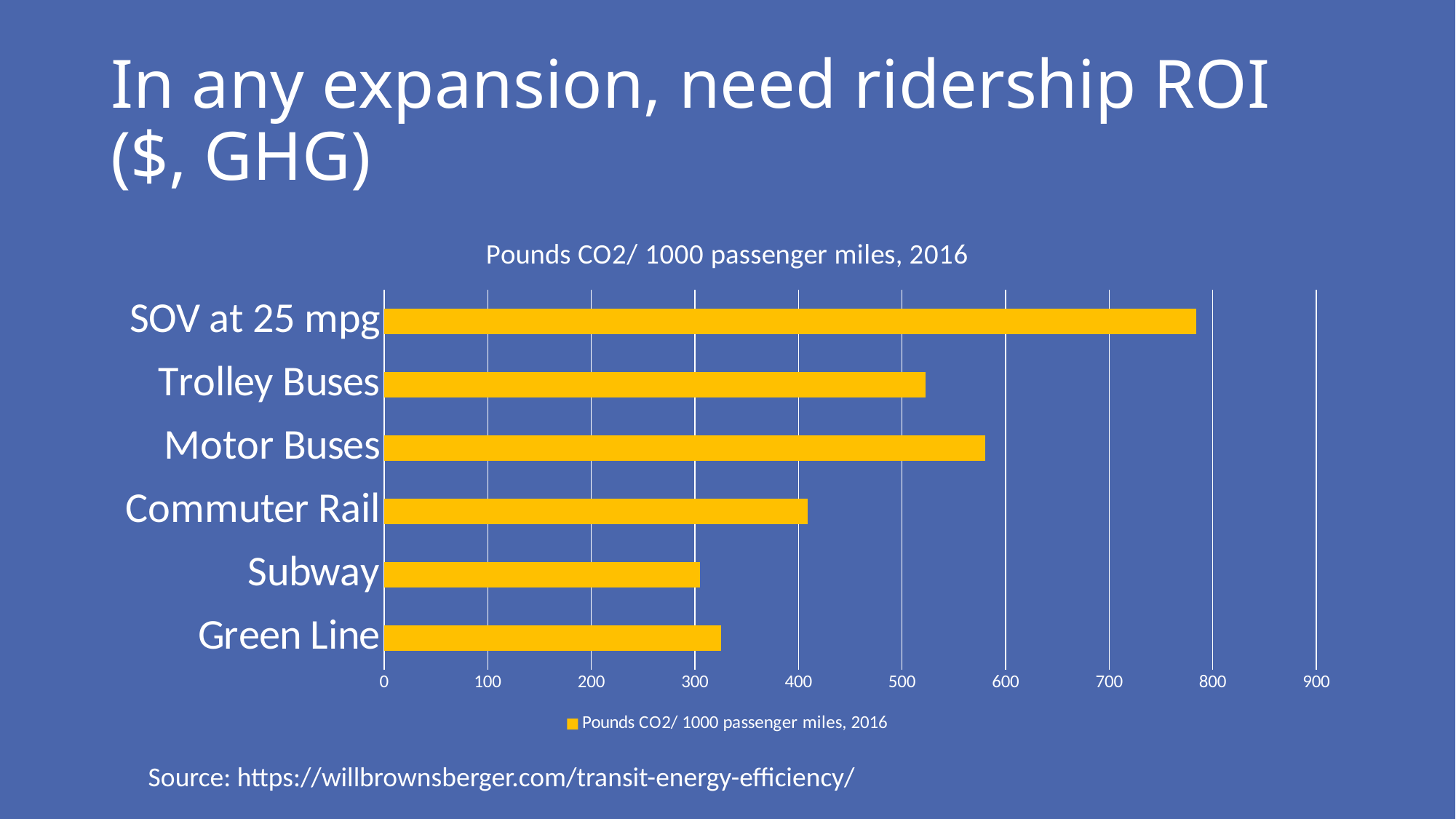
Is the value for Motor Buses greater or less than 500? greater What kind of chart is shown on the slide? bar chart Which category has the highest pounds of CO2 per 1000 passenger miles? SOV at 25 mpg What is the title of the chart? Pounds CO2/ 1000 passenger miles, 2016 Which has a higher value, Commuter Rail or Green Line? Commuter Rail How many series does the legend list? 1 How many transit categories are plotted in the chart? 6 Is the value for Green Line greater or less than 400? less Is the value for Commuter Rail greater or less than 500? less Which has a higher value, Motor Buses or Trolley Buses? Motor Buses Which category has the lowest pounds of CO2 per 1000 passenger miles? Subway